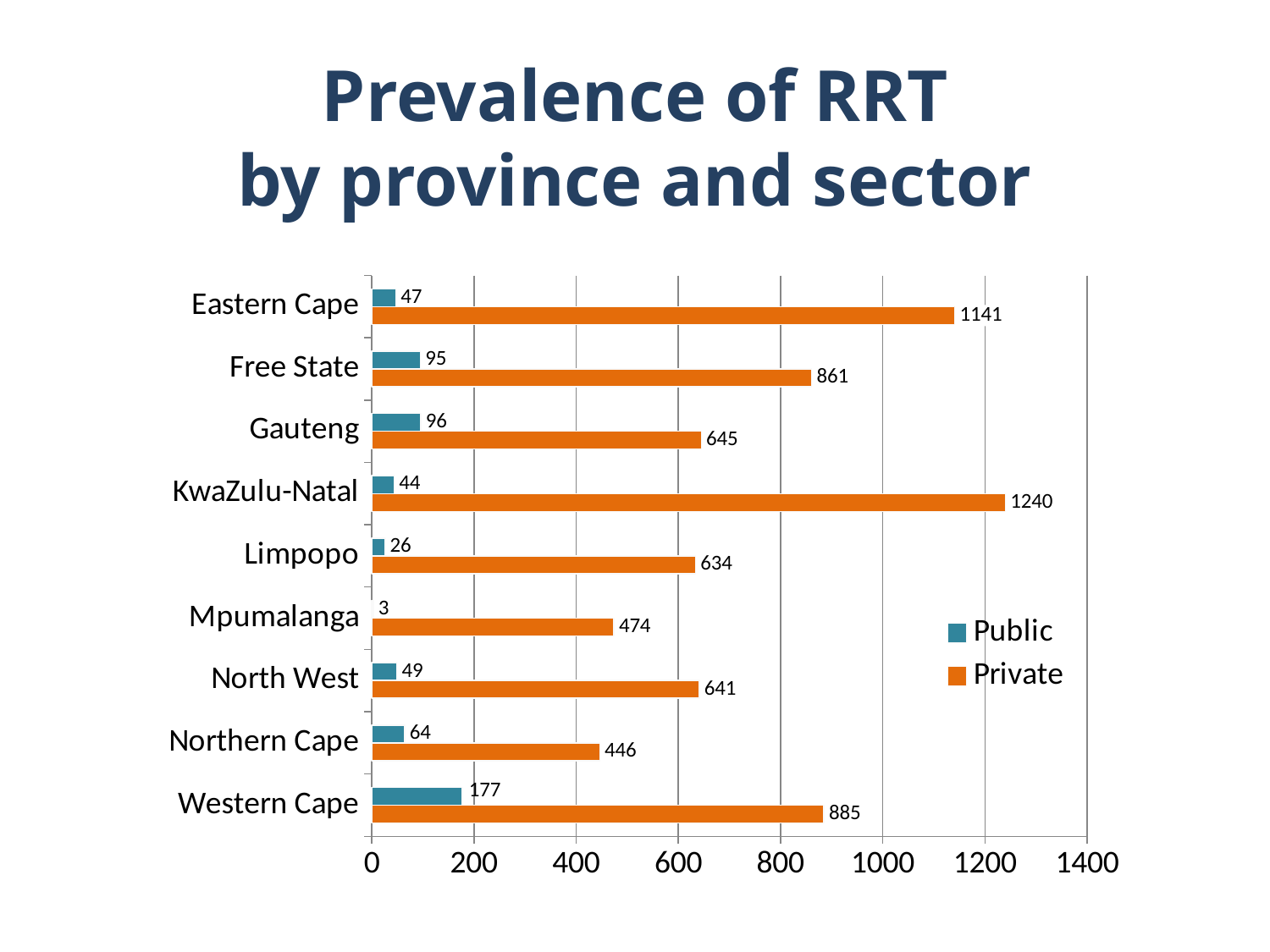
What is the title of the chart on the slide? Prevalence of RRT by province and sector What is the Private value for KwaZulu-Natal? 1240 Which province has the lowest Public value? Mpumalanga What is the difference between the Private and Public values for Eastern Cape? 1094 Which is larger, the Private value for Free State or the Private value for Western Cape? Western Cape How many series does the legend list? 2 What is the Private value for Mpumalanga? 474 Which province has the highest Private value? KwaZulu-Natal Is the Private value for Gauteng greater or less than 600? greater What kind of chart is shown on the slide? Bar chart How many provinces are shown on the chart? 9 What is the Public value for Western Cape? 177